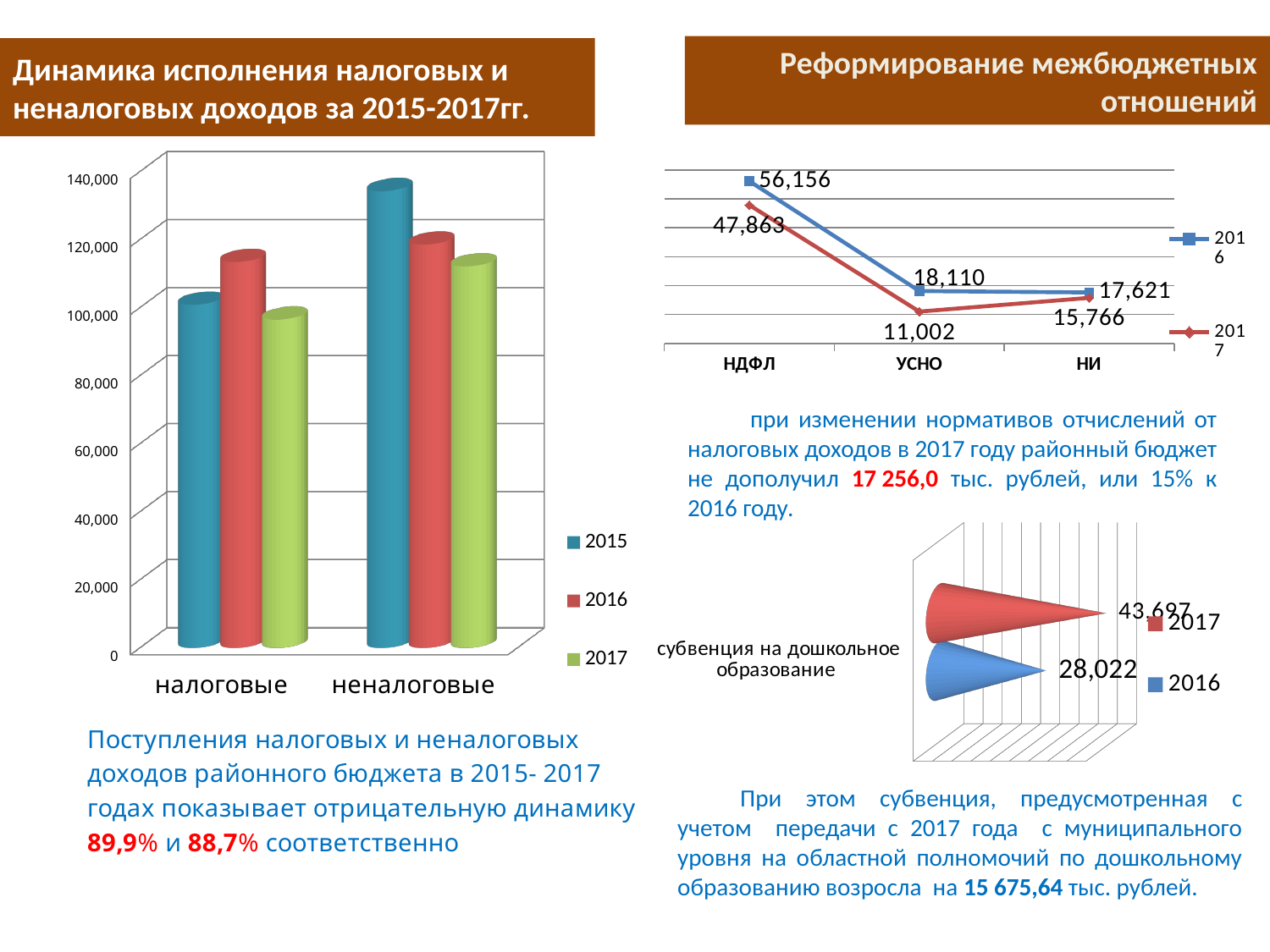
In the line chart at the top right, do the 2016 values rise or fall from НДФЛ to НИ? fall In the line chart at the top right, what is the 2016 value for НДФЛ? 56,156 In the cone chart at the bottom right (субвенция на дошкольное образование), what is the value for 2017? 43,697 In the line chart at the top right, what is the difference between the 2016 and 2017 values for НДФЛ? 8,293 In the cone chart at the bottom right (субвенция на дошкольное образование), what is the difference between the 2017 and 2016 values? 15,675 In the line chart at the top right, what is the 2017 value for НИ? 15,766 In the bar chart on the left, which year has the highest value for налоговые? 2016 In the line chart at the top right, what is the 2017 value for УСНО? 11,002 In the bar chart on the left (Динамика исполнения налоговых и неналоговых доходов), what kind of chart is it? bar chart In the bar chart on the left, is the 2015 value for неналоговые greater or less than 120,000? greater In the line chart at the top right, which category has the highest 2016 value? НДФЛ In the line chart at the top right, how many series does the legend list? 2